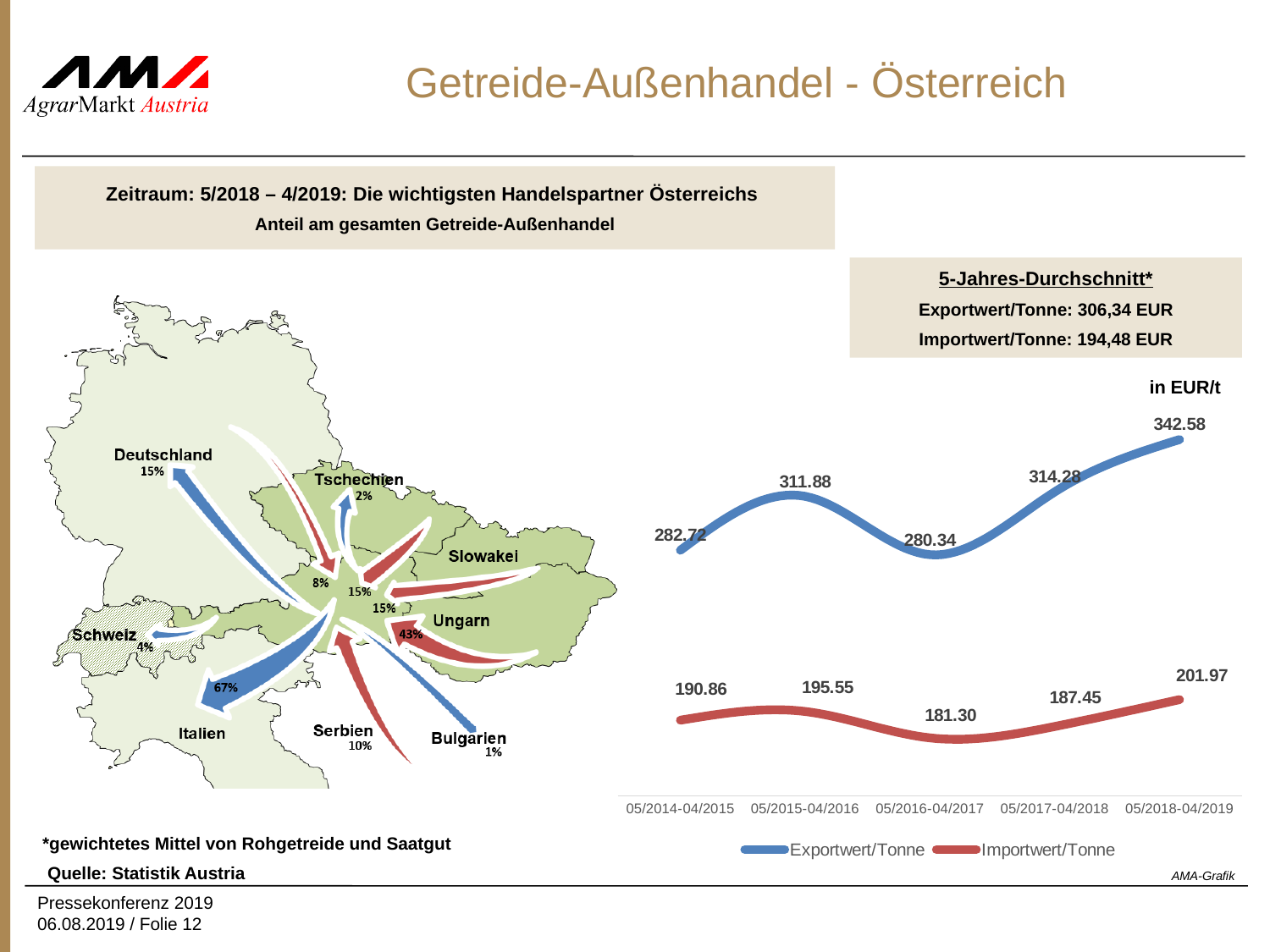
Which colour is used for the Importwert/Tonne line? Red Does the Importwert/Tonne rise or fall from 05/2017-04/2018 to 05/2018-04/2019? Rise How many series does the legend of the line chart list? 2 Which is larger, the Exportwert/Tonne in 05/2015-04/2016 or in 05/2016-04/2017? 05/2015-04/2016 What is the Importwert/Tonne value for 05/2016-04/2017? 181.30 What is the difference between the Exportwert/Tonne and the Importwert/Tonne in 05/2018-04/2019? 140.61 What is the Exportwert/Tonne value for 05/2014-04/2015? 282.72 What is the Exportwert/Tonne value for 05/2018-04/2019? 342.58 In which period is the Importwert/Tonne lowest? 05/2016-04/2017 In which period is the Exportwert/Tonne highest? 05/2018-04/2019 How many periods are plotted on the x axis of the line chart? 5 What kind of chart shows the Exportwert/Tonne and Importwert/Tonne values? Line chart